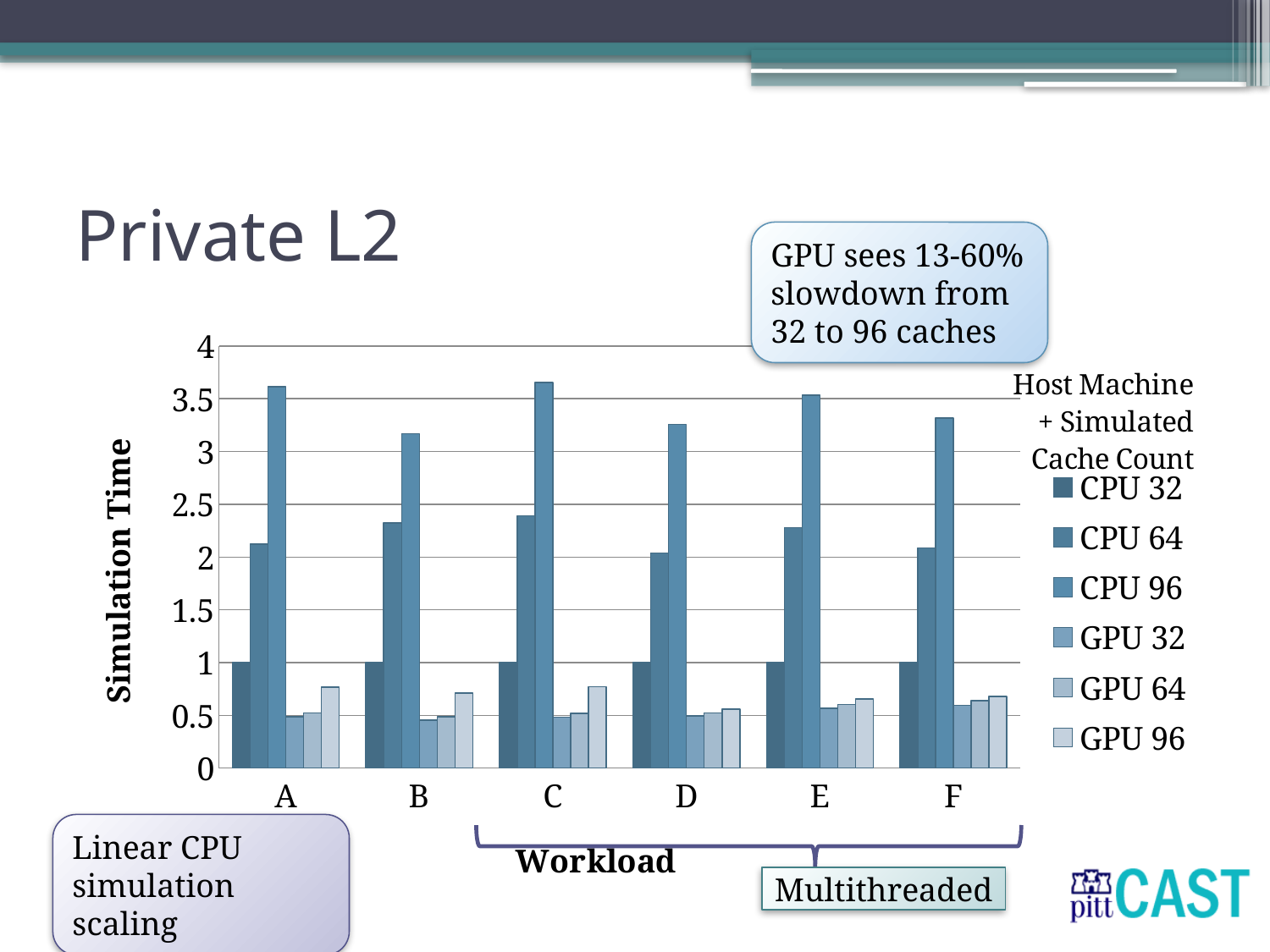
What is the simulation time for CPU 32 on workload A? 1 What is the simulation time for CPU 32 on workload F? 1 Is the simulation time for CPU 64 on workload B greater or less than 2? greater Is the simulation time for GPU 96 on workload A greater or less than 0.5? greater Is the simulation time for CPU 96 on workload B greater or less than 3.5? less For workload E, which is larger: the simulation time for CPU 64 or for GPU 64? CPU 64 What is the title of the y axis? Simulation Time Which series has the highest simulation time for workload A? CPU 96 How many workloads are shown on the x axis? 6 How many series does the legend list? 6 What kind of chart is shown on the slide? bar chart